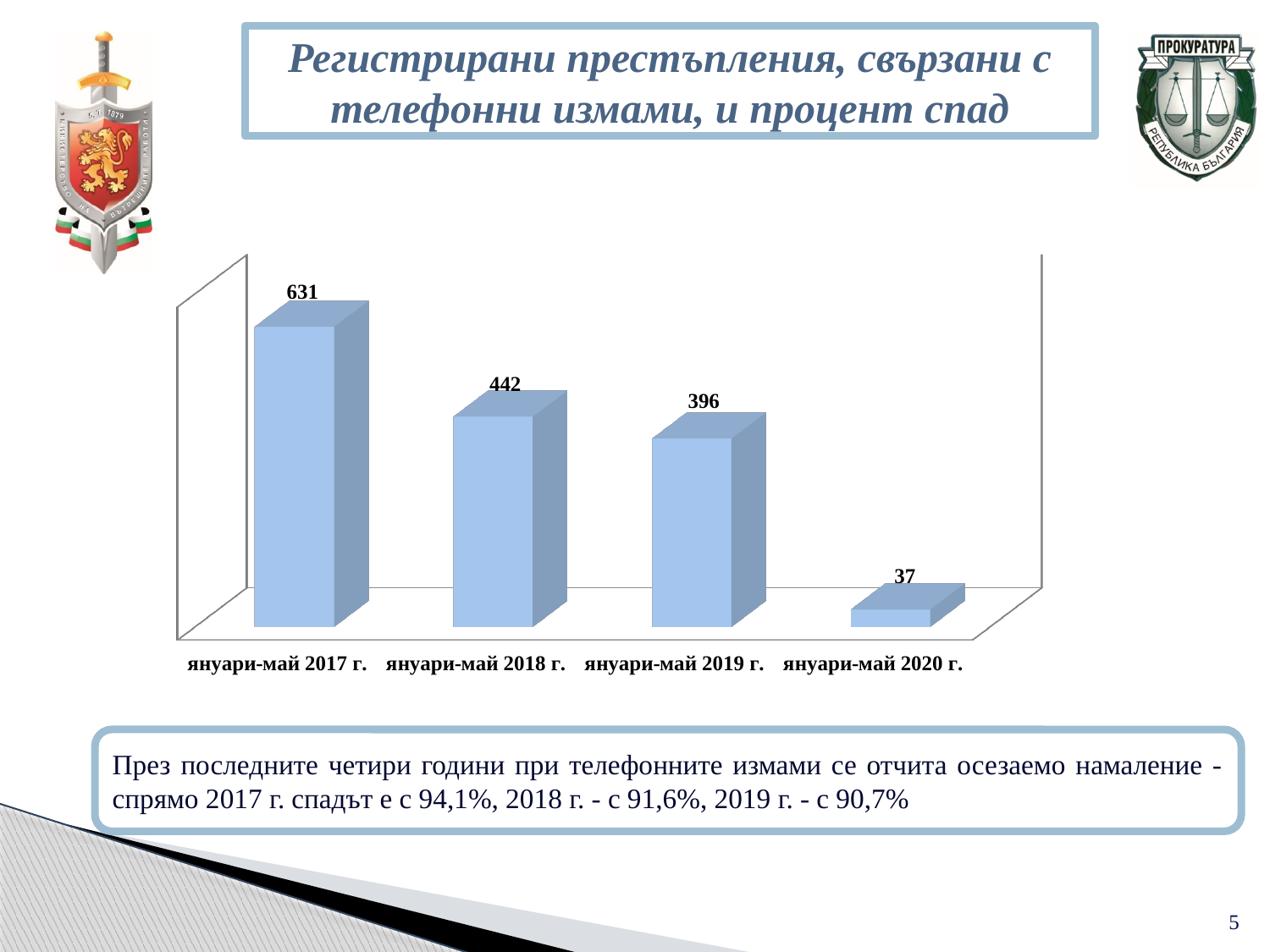
Which period has the highest value? януари-май 2017 г. Which period has the lowest value? януари-май 2020 г. How many periods are shown on the chart? 4 What is the value for януари-май 2017 г.? 631 What is the value for януари-май 2019 г.? 396 What kind of chart is shown on the slide? bar chart What is the difference between the values for януари-май 2019 г. and януари-май 2020 г.? 359 Which is larger, the value for януари-май 2018 г. or януари-май 2019 г.? януари-май 2018 г. What is the value for януари-май 2018 г.? 442 What is the difference between the values for януари-май 2017 г. and януари-май 2018 г.? 189 What is the value for януари-май 2020 г.? 37 Do the values rise or fall from януари-май 2017 г. to януари-май 2020 г.? fall